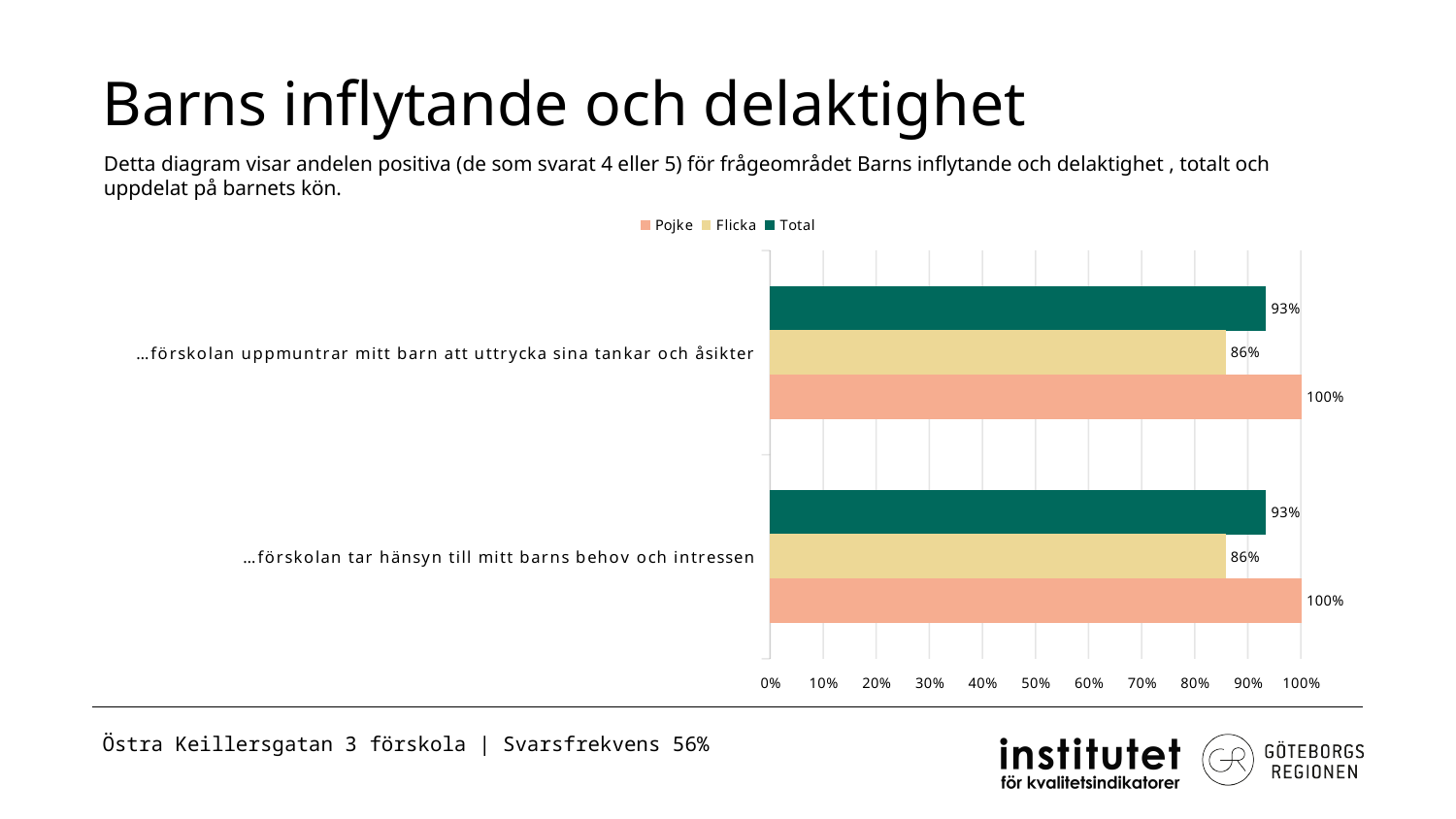
What kind of chart is shown on the slide? bar chart What is the Flicka value for "…förskolan tar hänsyn till mitt barns behov och intressen"? 86% How many categories are plotted on the chart? 2 What is the Pojke value for "…förskolan uppmuntrar mitt barn att uttrycka sina tankar och åsikter"? 100% How many series does the legend list? 3 Which series has the lowest value for "…förskolan tar hänsyn till mitt barns behov och intressen"? Flicka What is the difference between the Pojke and Flicka values for "…förskolan tar hänsyn till mitt barns behov och intressen"? 14% Is the Flicka value for "…förskolan uppmuntrar mitt barn att uttrycka sina tankar och åsikter" greater or less than 90%? less What is the Total value for "…förskolan uppmuntrar mitt barn att uttrycka sina tankar och åsikter"? 93% Which is larger for "…förskolan uppmuntrar mitt barn att uttrycka sina tankar och åsikter": the Total value or the Flicka value? Total Which series has the highest value for "…förskolan uppmuntrar mitt barn att uttrycka sina tankar och åsikter"? Pojke Which legend entry is shown in green? Total